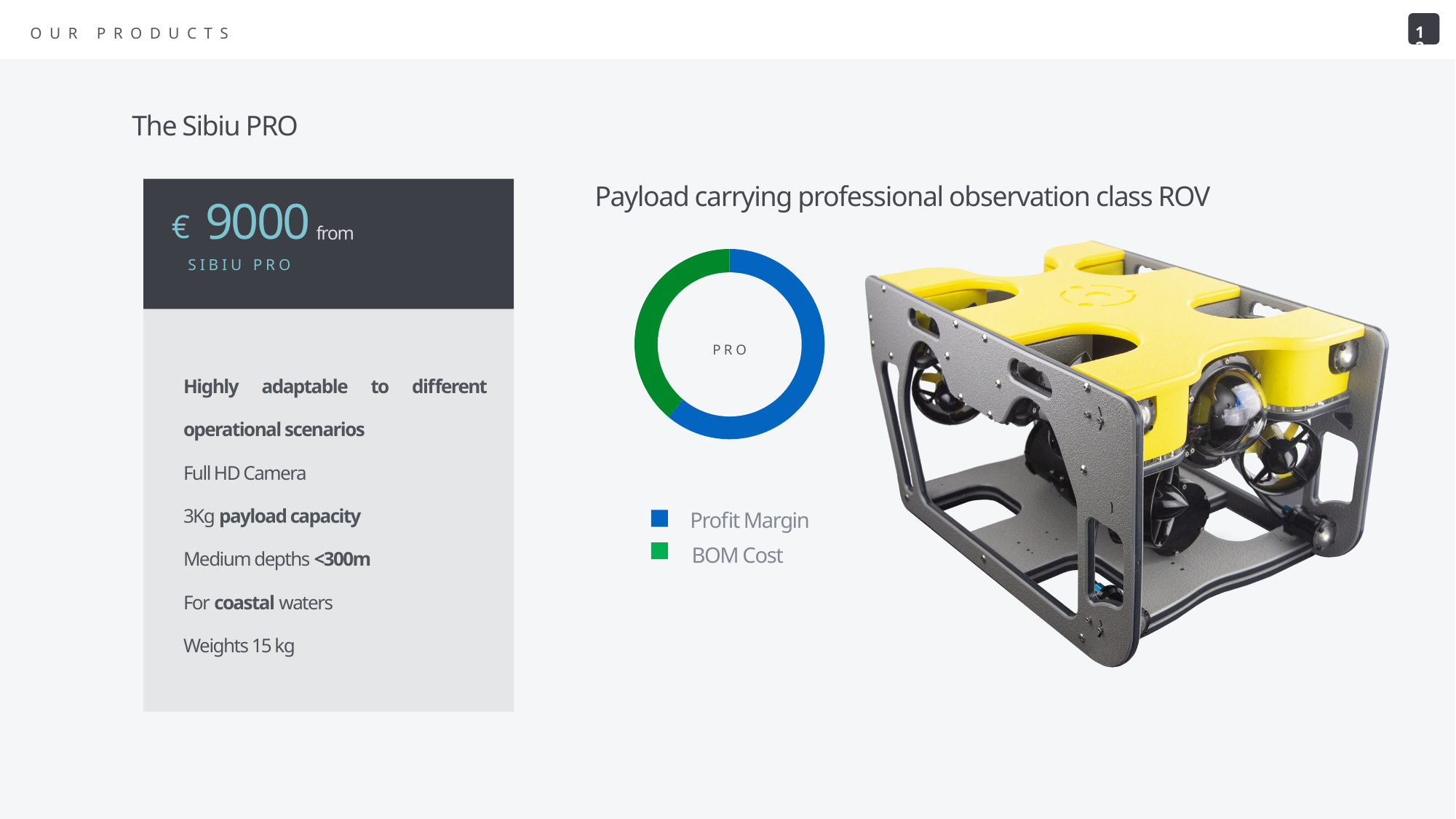
What text is shown in the centre of the donut chart? PRO Which slice of the donut chart is the smallest? BOM Cost Which is larger in the donut chart, Profit Margin or BOM Cost? Profit Margin What colour represents Profit Margin in the donut chart? Blue How many slices does the donut chart have? 2 How many entries does the legend of the donut chart list? 2 What kind of chart is shown on the slide? Pie chart (donut) Which slice of the donut chart is the largest? Profit Margin